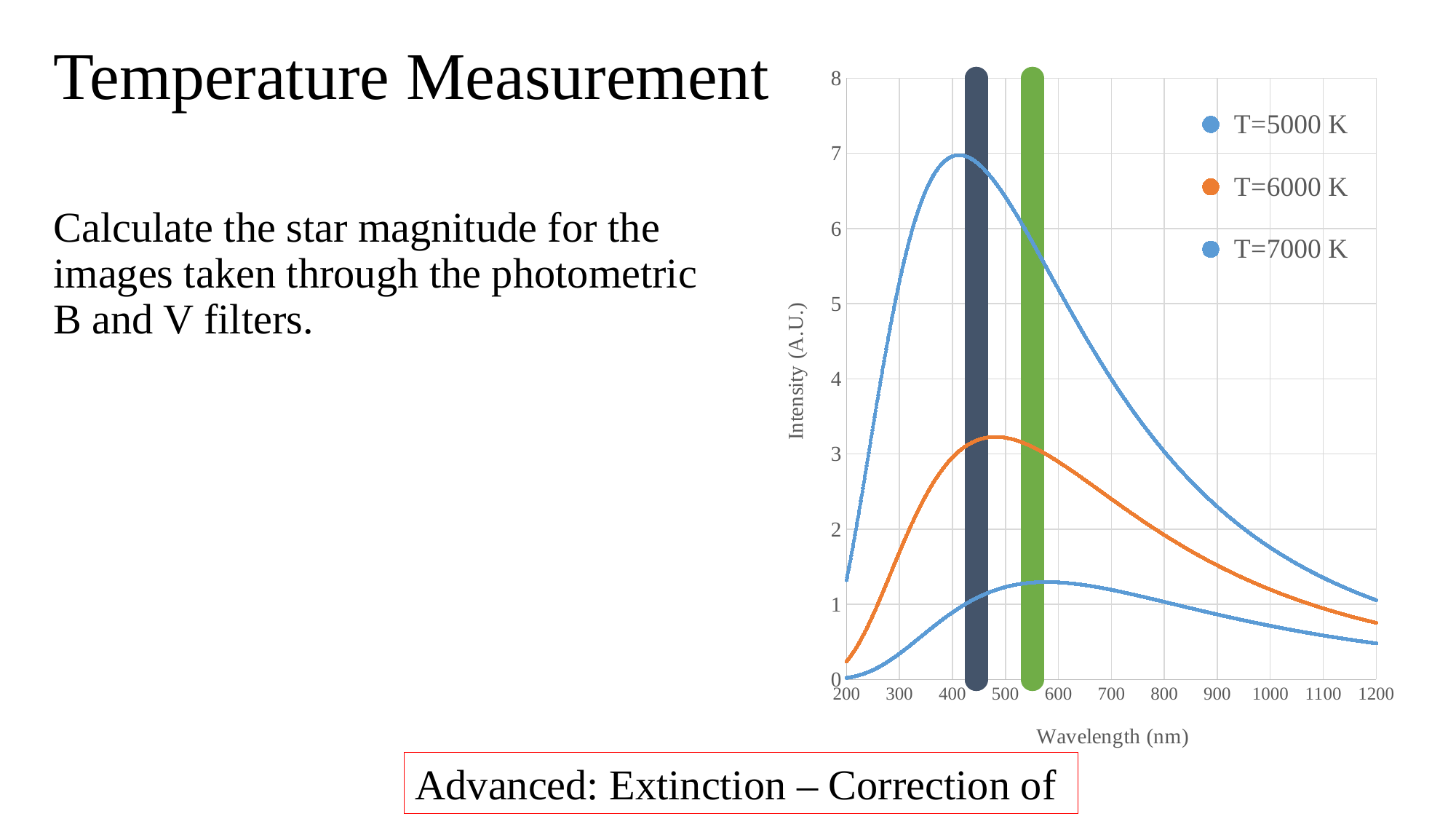
Is the value of the T=6000 K curve at 200 nm greater or less than 1? less Is the peak value of the T=6000 K curve greater or less than 4? less Does the T=6000 K curve rise or fall between 600 nm and 1200 nm? fall What kind of chart is shown on the slide? line chart What is the label of the chart's y axis? Intensity (A.U.) Which series in the legend is drawn in orange? T=6000 K Is the value of the T=6000 K curve at 1200 nm greater or less than 1? less How many series does the chart legend list? 3 Does the T=6000 K curve rise or fall between 200 nm and 400 nm? rise What is the label of the chart's x axis? Wavelength (nm)